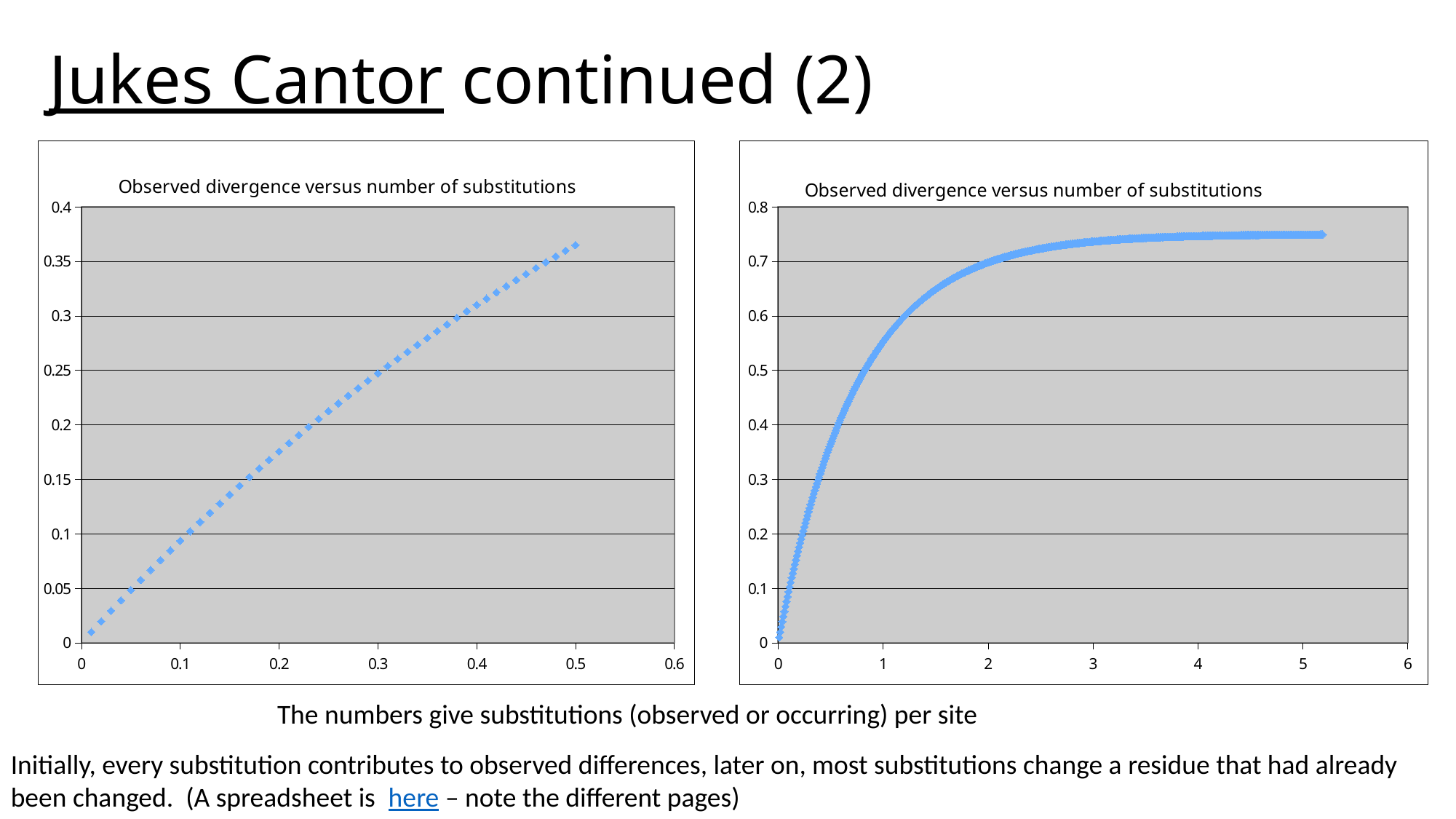
In the right chart, is the value at x = 5 greater or less than 0.7? greater In the left chart, is the value at x = 0.1 greater or less than 0.15? less What type of chart is the right chart? scatter chart In the left chart, is the value at x = 0.5 greater or less than 0.35? greater In the right chart, which is larger, the value at x = 1 or the value at x = 3? the value at x = 3 What type of chart is the left chart? scatter chart In the left chart, do the values rise or fall as the x axis increases? rise What is the highest value shown on the y axis of the right chart? 0.8 In the right chart, do the values rise or fall as the x axis increases? rise What is the title of the left chart? Observed divergence versus number of substitutions